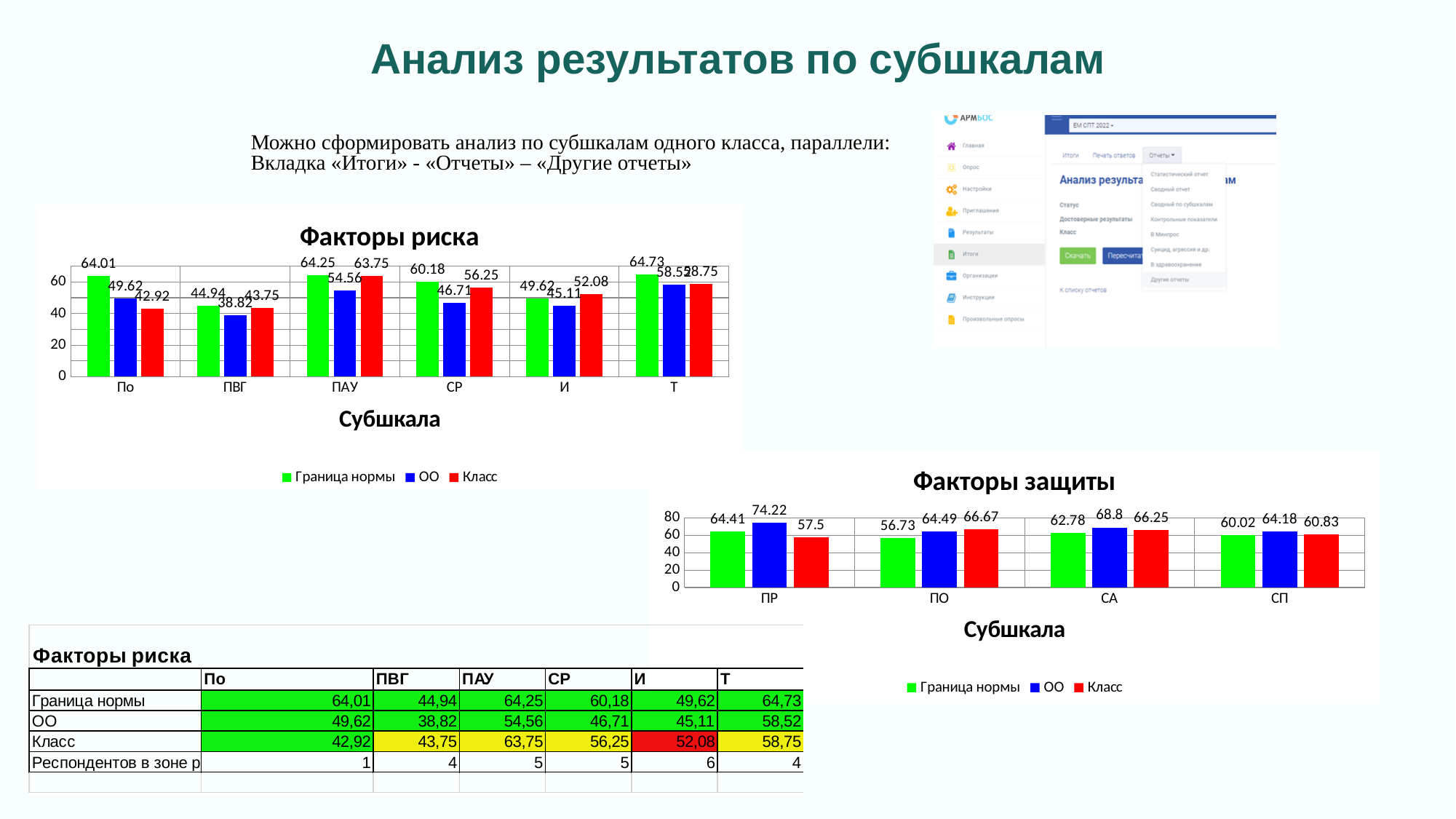
In the 'Факторы защиты' chart, which category has the highest 'ОО' value? ПР In the 'Факторы защиты' chart, what is the value of 'ОО' for ПР? 74.22 In the 'Факторы риска' chart, how many categories are shown on the x axis? 6 In the 'Факторы защиты' chart, how many series does the legend list? 3 In the 'Факторы защиты' chart, which is larger for СА: 'Граница нормы' or 'ОО'? ОО In the 'Факторы риска' chart, what is the difference between 'Граница нормы' and 'Класс' for По? 21.09 In the 'Факторы защиты' chart, what is the value of 'Класс' for ПО? 66.67 In the 'Факторы риска' chart, what is the value of 'Граница нормы' for ПАУ? 64.25 What type of chart is 'Факторы защиты'? Bar chart In the 'Факторы риска' chart, which category has the lowest 'ОО' value? ПВГ In the 'Факторы риска' chart, what is the value of 'Класс' for И? 52.08 In the 'Факторы риска' chart, which category has the highest 'Граница нормы' value? Т